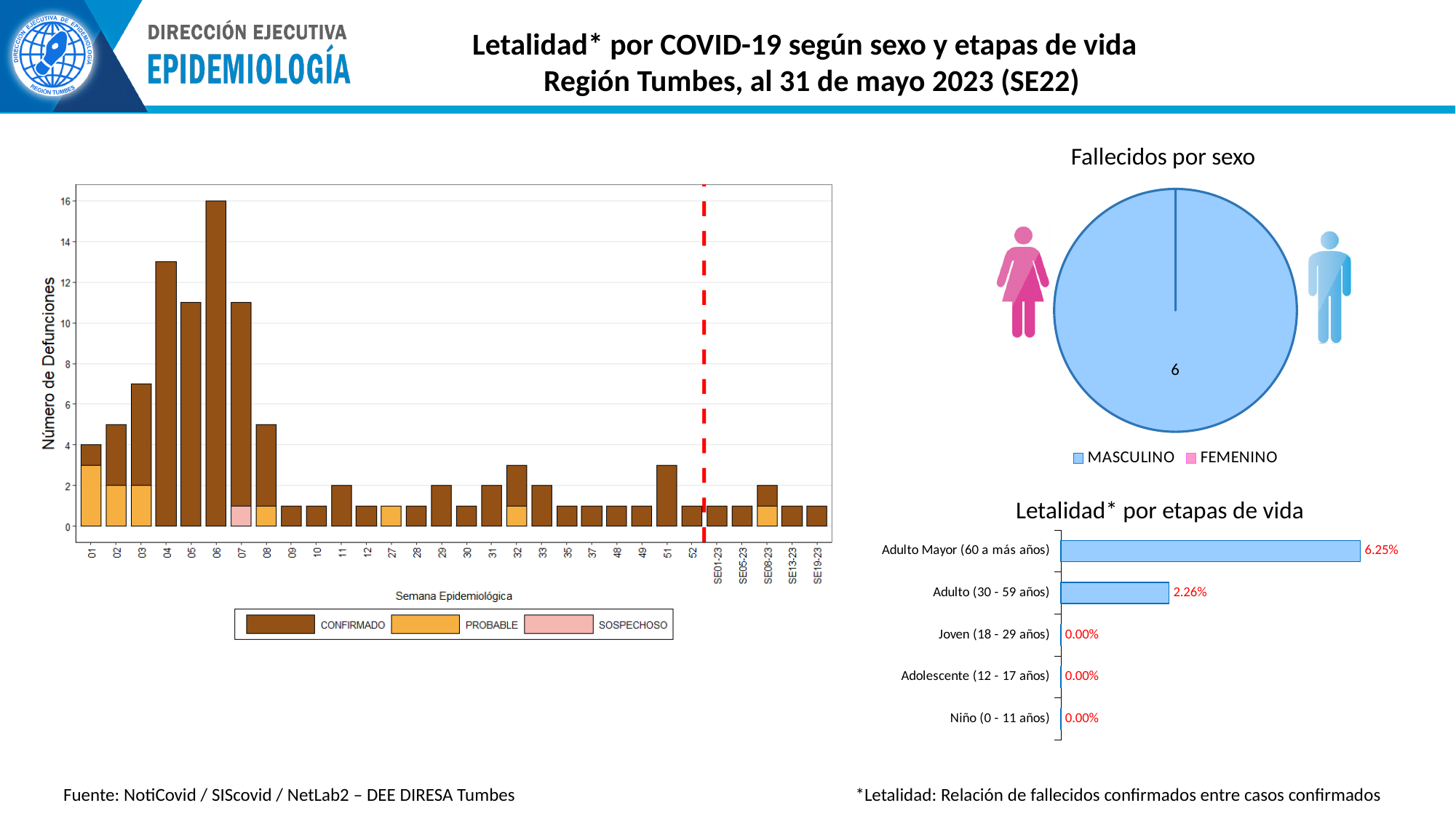
In the 'Número de Defunciones' chart on the left, is the value for semana 04 greater or less than 12? greater In the 'Letalidad* por etapas de vida' chart, what is the difference between the values for Adulto Mayor (60 a más años) and Adulto (30 - 59 años)? 3.99% In the 'Letalidad* por etapas de vida' chart, which age group has the highest letalidad? Adulto Mayor (60 a más años) In the 'Fallecidos por sexo' pie chart, what value is shown for MASCULINO? 6 In the 'Número de Defunciones' chart on the left, how many series does the legend list? 3 In the 'Letalidad* por etapas de vida' chart, what is the value for Adulto Mayor (60 a más años)? 6.25% In the 'Número de Defunciones' chart on the left, which semana epidemiológica has the highest number of deaths? 06 In the 'Letalidad* por etapas de vida' chart, what is the value for Joven (18 - 29 años)? 0.00% In the 'Letalidad* por etapas de vida' chart, what is the value for Adulto (30 - 59 años)? 2.26% What kind of chart is the 'Número de Defunciones' chart on the left? Stacked bar chart In the 'Letalidad* por etapas de vida' chart, how many age groups are shown? 5 In the 'Fallecidos por sexo' pie chart, how many entries does the legend list? 2